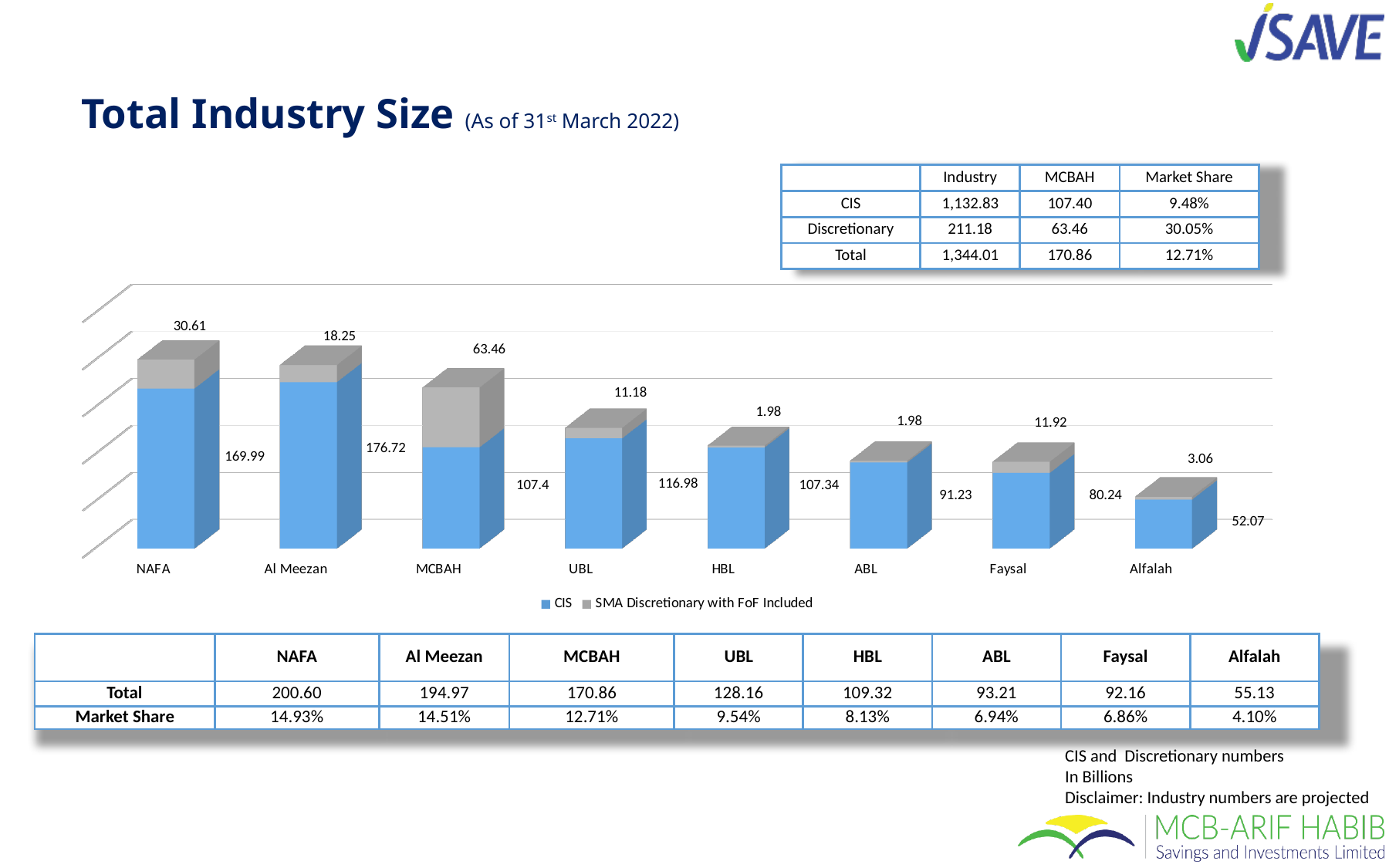
Which category has the lowest CIS value? Alfalah Which category has the highest CIS value? Al Meezan What is the difference between the CIS values of NAFA and MCBAH? 62.59 What type of chart is shown on the slide? Stacked bar chart Which is larger, the SMA Discretionary value for NAFA or for Faysal? NAFA How many series does the chart legend list? 2 Which category has the highest SMA Discretionary with FoF Included value? MCBAH What is the SMA Discretionary with FoF Included value for MCBAH? 63.46 What is the CIS value for Alfalah? 52.07 What is the CIS value for Al Meezan? 176.72 How many categories are shown on the x axis of the chart? 8 What is the total of the stacked bar for UBL (CIS plus SMA Discretionary)? 128.16